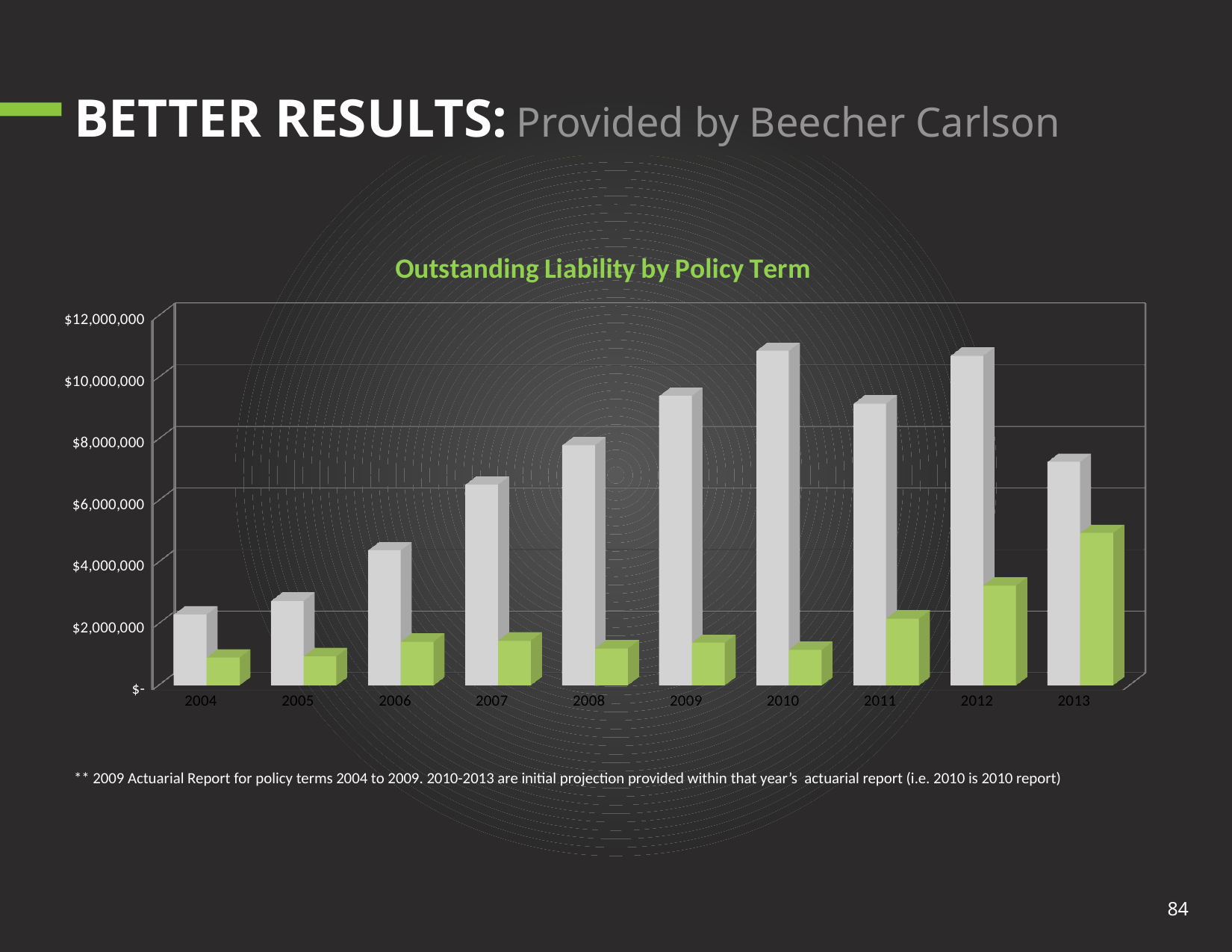
What is the title of the chart? Outstanding Liability by Policy Term What kind of chart is shown on the slide? Bar chart Is the green bar for 2013 greater or less than $4,000,000? greater Which year has the shortest grey bar in the chart? 2004 How many policy term years are shown on the x axis of the chart? 10 Which year has the tallest green bar in the chart? 2013 How many bars are plotted for each year in the chart? 2 Is the grey bar for 2004 greater or less than $4,000,000? less Do the grey bars rise or fall from 2004 to 2010? rise Which is larger, the grey bar for 2005 or the grey bar for 2006? 2006 Is the grey bar for 2009 greater or less than $10,000,000? less